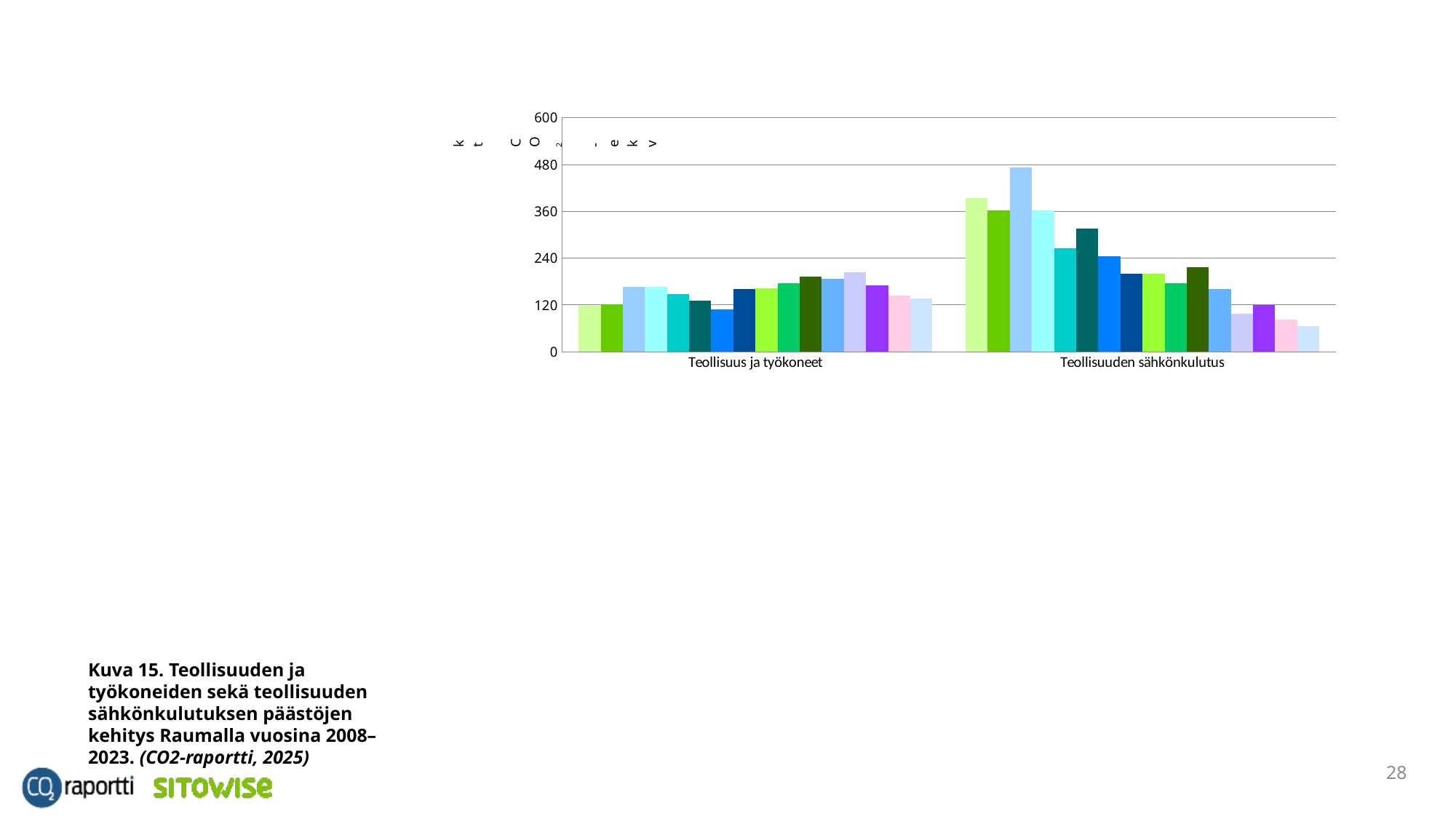
What unit is given on the y axis of the chart? kt CO2-ekv Is the leftmost bar in the Teollisuuden sähkönkulutus group greater or less than 360? greater What is the highest value shown on the y axis of the chart? 600 Do the bars in the Teollisuuden sähkönkulutus group generally rise or fall from left to right? fall Which is larger: the leftmost bar of Teollisuus ja työkoneet or the leftmost bar of Teollisuuden sähkönkulutus? Teollisuuden sähkönkulutus Is the rightmost bar in the Teollisuuden sähkönkulutus group greater or less than 120? less Is the tallest bar in the Teollisuuden sähkönkulutus group greater or less than 360? greater What kind of chart is shown on the slide? Bar chart How many categories are shown on the x axis of the chart? 2 Which category contains the tallest bar in the chart? Teollisuuden sähkönkulutus How many bars are plotted for the category Teollisuuden sähkönkulutus? 16